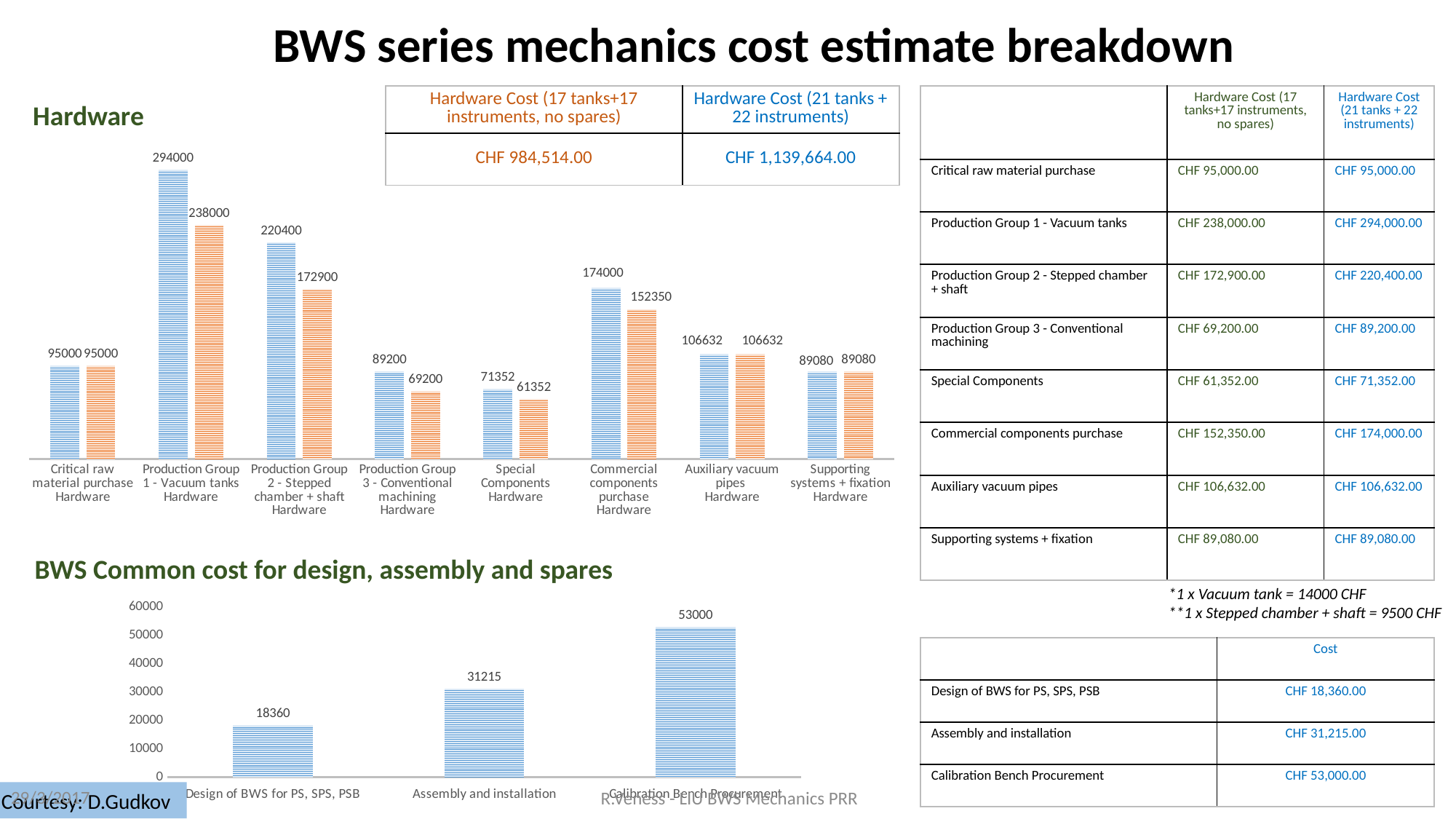
In the Hardware chart, what is the value of the orange bar for Production Group 2 - Stepped chamber + shaft Hardware? 172900 In the Hardware chart, what is the value of the blue bar for Production Group 1 - Vacuum tanks Hardware? 294000 What kind of chart is the BWS Common cost for design, assembly and spares chart? bar chart In the Hardware chart, what is the value of the orange bar for Commercial components purchase Hardware? 152350 In the BWS Common cost for design, assembly and spares chart, what is the value for Assembly and installation? 31215 In the BWS Common cost for design, assembly and spares chart, what is the difference between Calibration Bench Procurement and Design of BWS for PS, SPS, PSB? 34640 In the Hardware chart, is the blue bar for Production Group 3 - Conventional machining Hardware larger or smaller than the blue bar for Auxiliary vacuum pipes Hardware? smaller In the BWS Common cost for design, assembly and spares chart, which category has the highest value? Calibration Bench Procurement In the Hardware chart, which category has the lowest orange bar? Special Components Hardware In the Hardware chart, what is the difference between the blue and orange bars for Production Group 1 - Vacuum tanks Hardware? 56000 In the Hardware chart, which category has the highest blue bar? Production Group 1 - Vacuum tanks Hardware In the Hardware chart, how many categories are shown on the x axis? 8